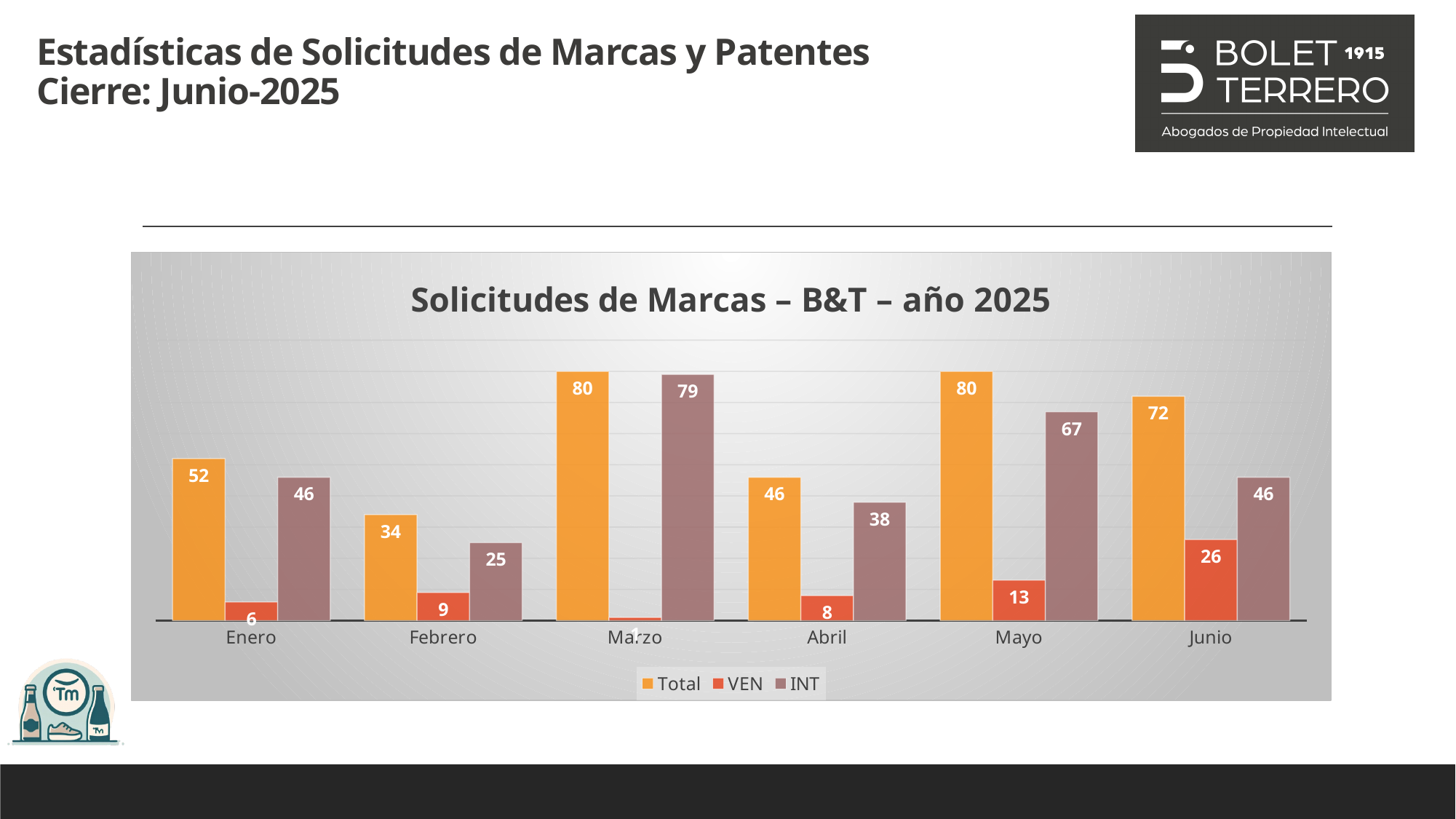
Which month has the highest INT value? Marzo What is the difference between the Total and INT values for Junio? 26 What is the INT value for Abril? 38 What kind of chart is shown on the slide? Bar chart What is the VEN value for Junio? 26 Which month has the highest VEN value? Junio What is the INT value for Mayo? 67 Which month has the lowest Total value? Febrero What is the Total value for Enero? 52 How many series does the legend list? 3 How many months are shown on the x axis? 6 Which is larger, the INT value for Enero or the INT value for Febrero? Enero